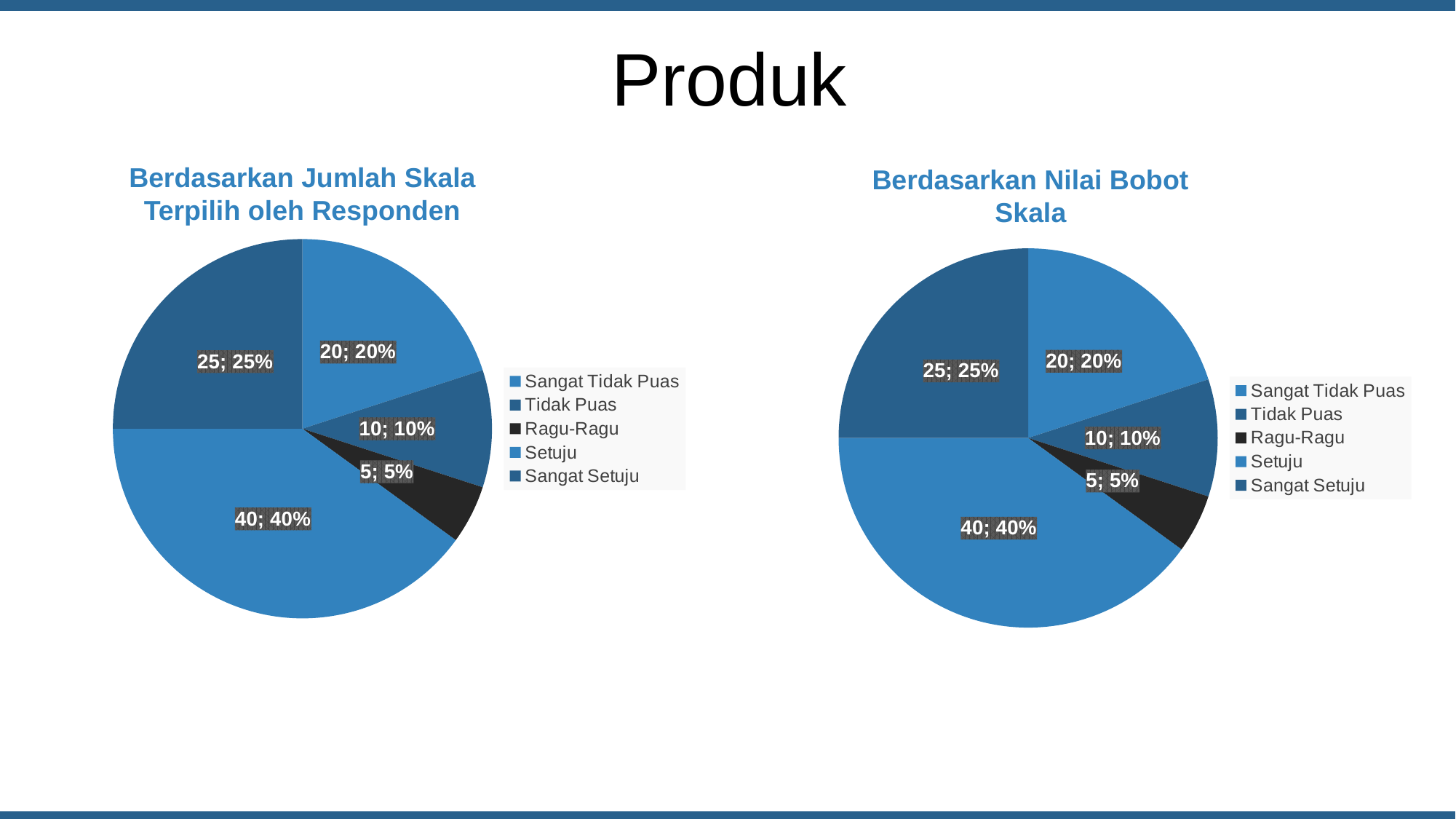
In the chart "Berdasarkan Jumlah Skala Terpilih oleh Responden", what is the combined value of Setuju and Sangat Setuju? 65 In the chart "Berdasarkan Jumlah Skala Terpilih oleh Responden", which category has the largest slice? Setuju In the chart "Berdasarkan Jumlah Skala Terpilih oleh Responden", which is larger: Tidak Puas or Sangat Tidak Puas? Sangat Tidak Puas In the chart "Berdasarkan Nilai Bobot Skala", what is the difference between the values for Setuju and Sangat Tidak Puas? 20 What type of chart is shown under the title "Berdasarkan Jumlah Skala Terpilih oleh Responden"? Pie chart What is the title of the pie chart on the right side of the slide? Berdasarkan Nilai Bobot Skala In the chart "Berdasarkan Jumlah Skala Terpilih oleh Responden", what share of the pie does Sangat Setuju represent? 25% In the chart "Berdasarkan Nilai Bobot Skala", what is the value for Ragu-Ragu? 5; 5% In the chart "Berdasarkan Nilai Bobot Skala", which category has the smallest slice? Ragu-Ragu In the chart "Berdasarkan Nilai Bobot Skala", what share of the pie does Tidak Puas represent? 10% How many categories does the legend of the chart "Berdasarkan Nilai Bobot Skala" list? 5 In the chart "Berdasarkan Jumlah Skala Terpilih oleh Responden", what is the value for Setuju? 40; 40%